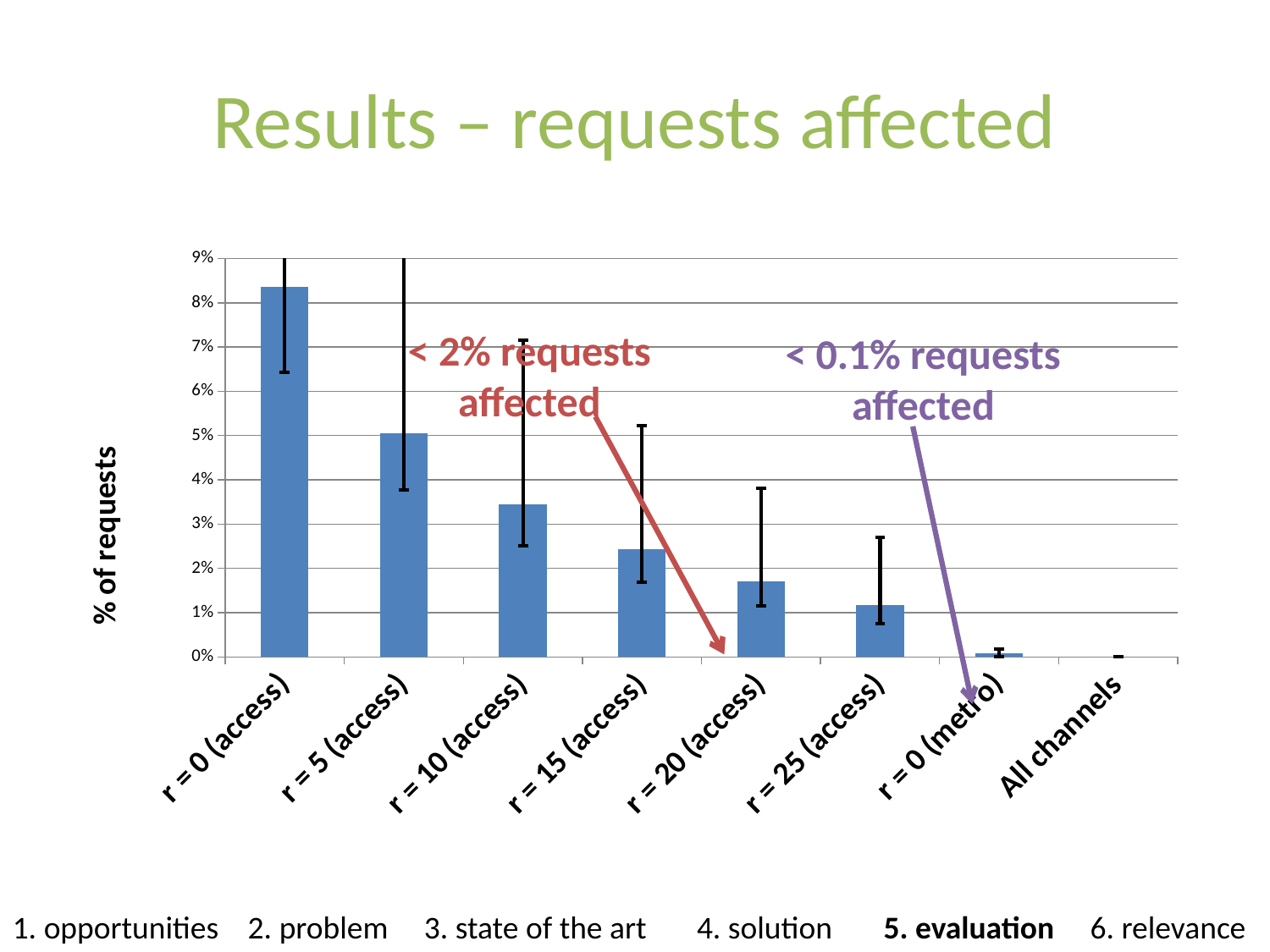
Is the value for r = 10 (access) greater or less than 3%? greater Is the value for r = 15 (access) greater or less than 3%? less Is the value for r = 0 (access) greater or less than 8%? greater What is the label of the y axis? % of requests What is the title of the slide containing the chart? Results – requests affected Which is larger, the value for r = 5 (access) or the value for r = 25 (access)? r = 5 (access) Which category has the highest value? r = 0 (access) How many categories are plotted on the x axis? 8 What kind of chart is shown on the slide? bar chart Do the bar values rise or fall moving from r = 0 (access) to r = 25 (access)? fall